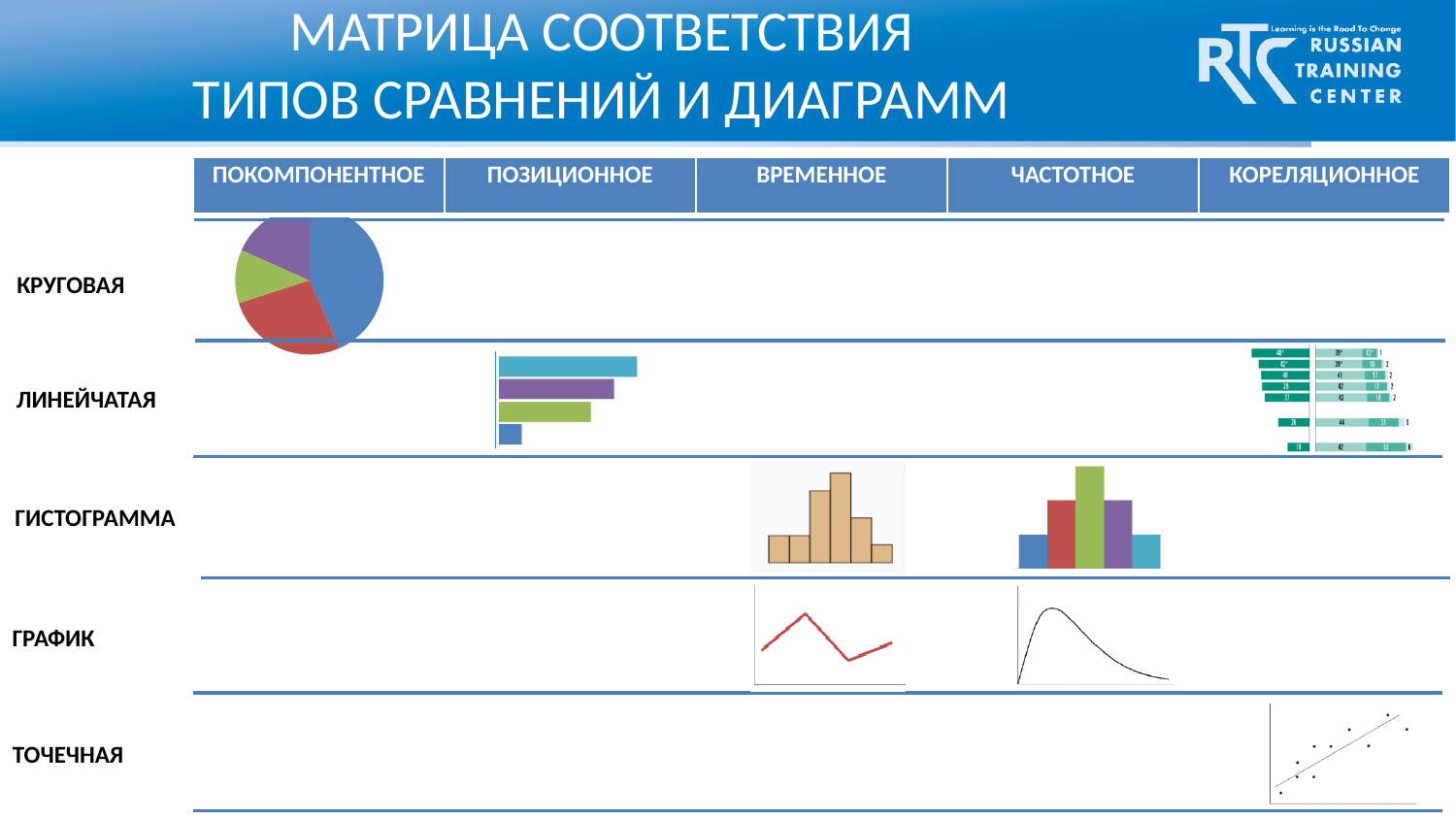
How many slices does the pie chart in the КРУГОВАЯ row have? 4 How many bars are in the histogram in the ГИСТОГРАММА row under the ВРЕМЕННОЕ column? 7 What kind of chart is shown in the ЛИНЕЙЧАТАЯ row under the ПОЗИЦИОННОЕ column? bar chart How many bars are in the histogram in the ГИСТОГРАММА row under the ЧАСТОТНОЕ column? 5 In the bar chart in the ЛИНЕЙЧАТАЯ row under ПОЗИЦИОННОЕ, which bar is the longest? the top (teal) bar Do the points in the scatter chart in the ТОЧЕЧНАЯ row rise or fall from left to right? rise In the bar chart in the ЛИНЕЙЧАТАЯ row under ПОЗИЦИОННОЕ, which bar is the shortest? the bottom (blue) bar In the histogram in the ГИСТОГРАММА row under ЧАСТОТНОЕ, which colour bar is the tallest? green Which colour slice is the largest in the pie chart in the КРУГОВАЯ row? blue How many comparison types are listed as column headers in the matrix? 5 What kind of chart is shown in the КРУГОВАЯ row under the ПОКОМПОНЕНТНОЕ column? pie chart